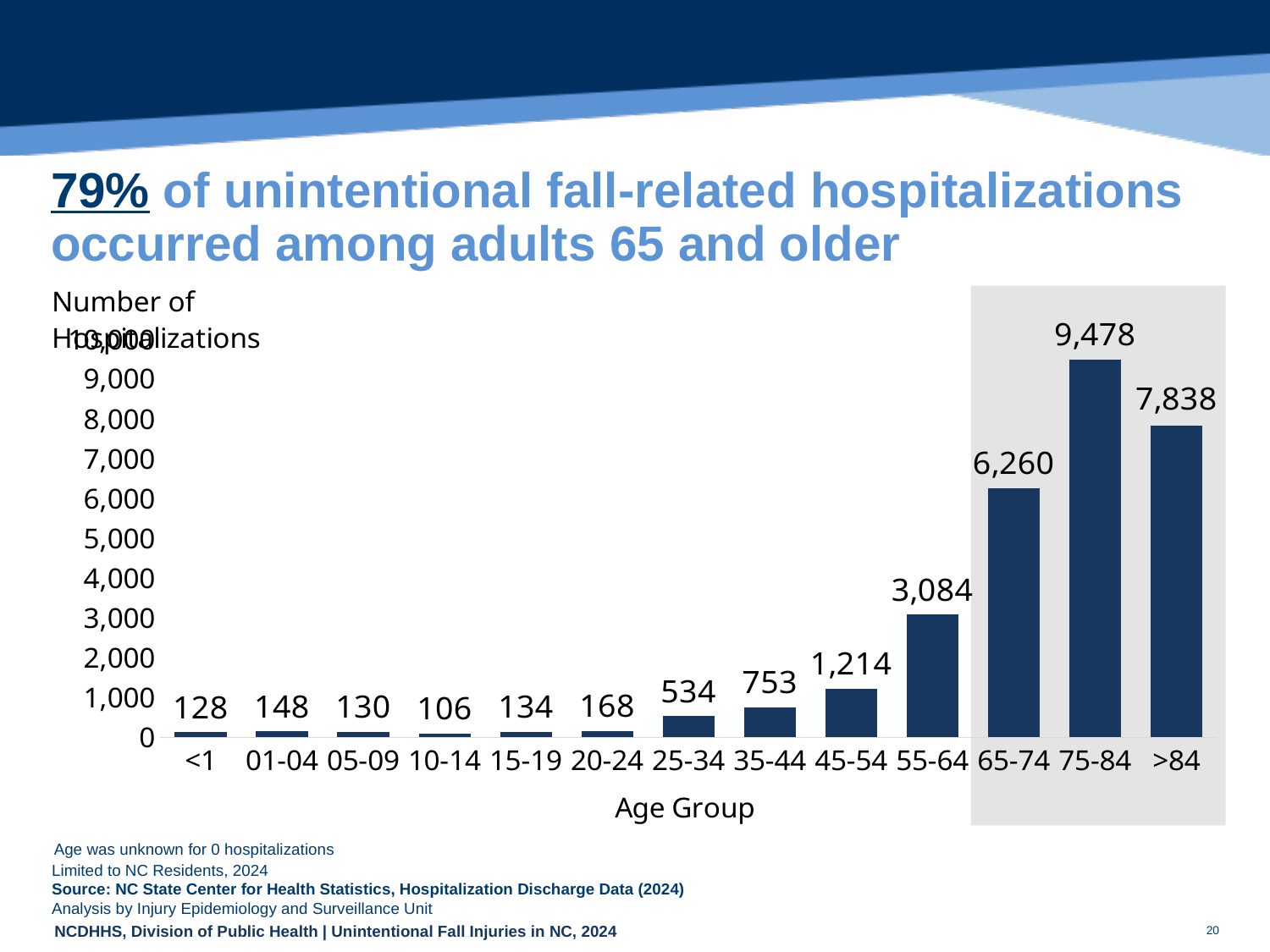
Which age group has more hospitalizations, 55-64 or 65-74? 65-74 What is the number of hospitalizations for the <1 age group? 128 Which age group has the lowest number of hospitalizations? 10-14 What is the difference in hospitalizations between the 75-84 and >84 age groups? 1,640 What is the number of hospitalizations for the 45-54 age group? 1,214 Which age group has the highest number of hospitalizations? 75-84 Do the values generally rise or fall from the 25-34 age group to the 75-84 age group? rise What kind of chart is shown on the slide? bar chart How many age groups are shown on the x axis? 13 What is the label of the x axis? Age Group What is the number of hospitalizations for the 75-84 age group? 9,478 Is the value for the 65-74 age group greater or less than 5,000? greater